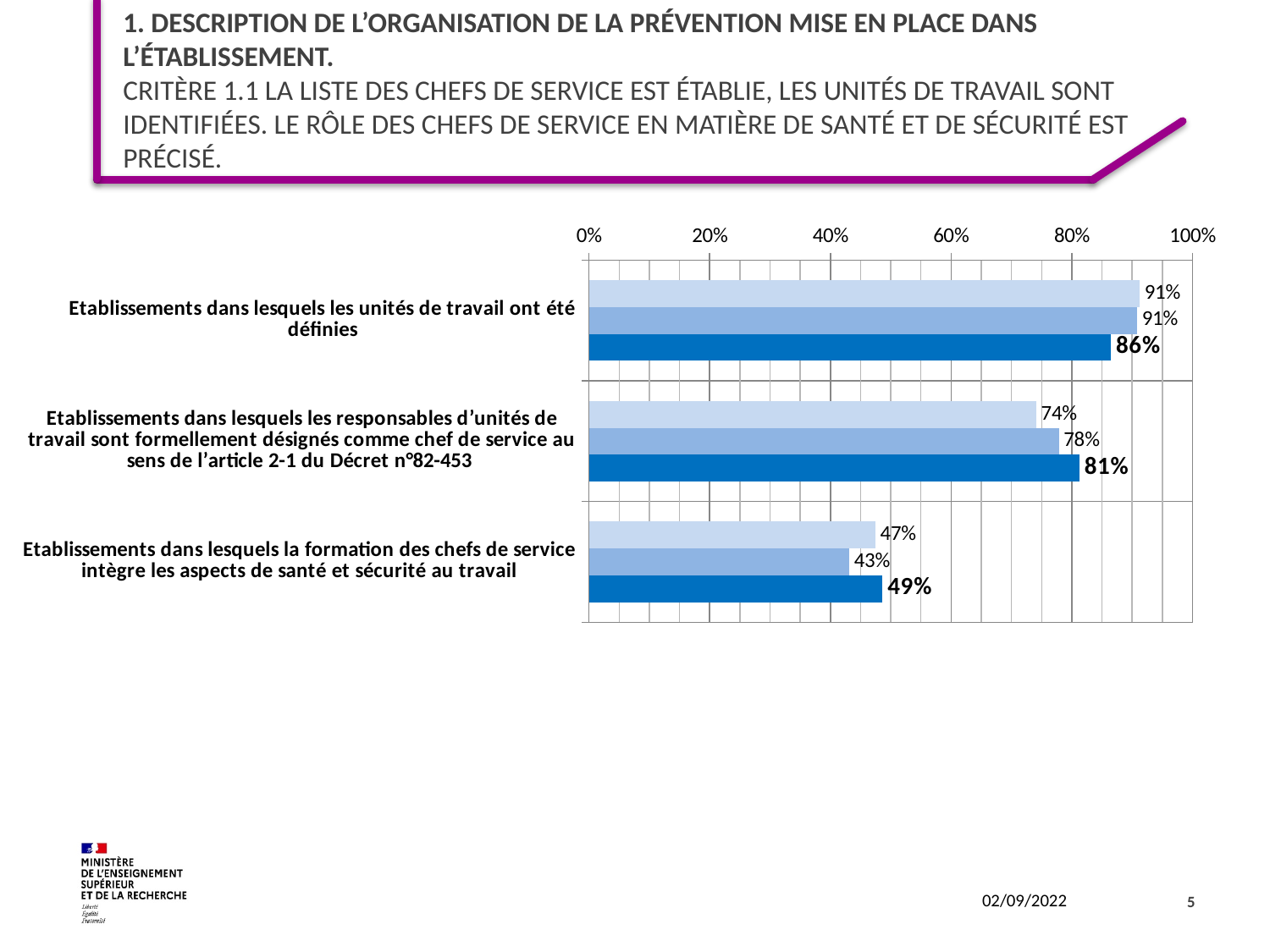
What is the value of the dark blue bar for "Etablissements dans lesquels les unités de travail ont été définies"? 86% Which category has the lowest dark blue bar value? Etablissements dans lesquels la formation des chefs de service intègre les aspects de santé et sécurité au travail What is the value of the middle bar for "Etablissements dans lesquels la formation des chefs de service intègre les aspects de santé et sécurité au travail"? 43% What type of chart is shown on the slide? Bar chart Is the dark blue bar value for "Etablissements dans lesquels les responsables d'unités de travail sont formellement désignés comme chef de service" greater or less than 80%? greater For "Etablissements dans lesquels la formation des chefs de service intègre les aspects de santé et sécurité au travail", which is larger: the topmost bar (47%) or the middle bar (43%)? The topmost bar (47%) Which category has the highest dark blue bar value? Etablissements dans lesquels les unités de travail ont été définies What is the value of the topmost (lightest blue) bar for "Etablissements dans lesquels les responsables d'unités de travail sont formellement désignés comme chef de service au sens de l'article 2-1 du Décret n°82-453"? 74% How many categories are shown on the chart? 3 What is the difference between the dark blue bar values for "Etablissements dans lesquels les unités de travail ont été définies" (86%) and "Etablissements dans lesquels les responsables d'unités de travail sont formellement désignés comme chef de service" (81%)? 5% How many bars are shown for each category? 3 What is the value of the dark blue bar for "Etablissements dans lesquels la formation des chefs de service intègre les aspects de santé et sécurité au travail"? 49%